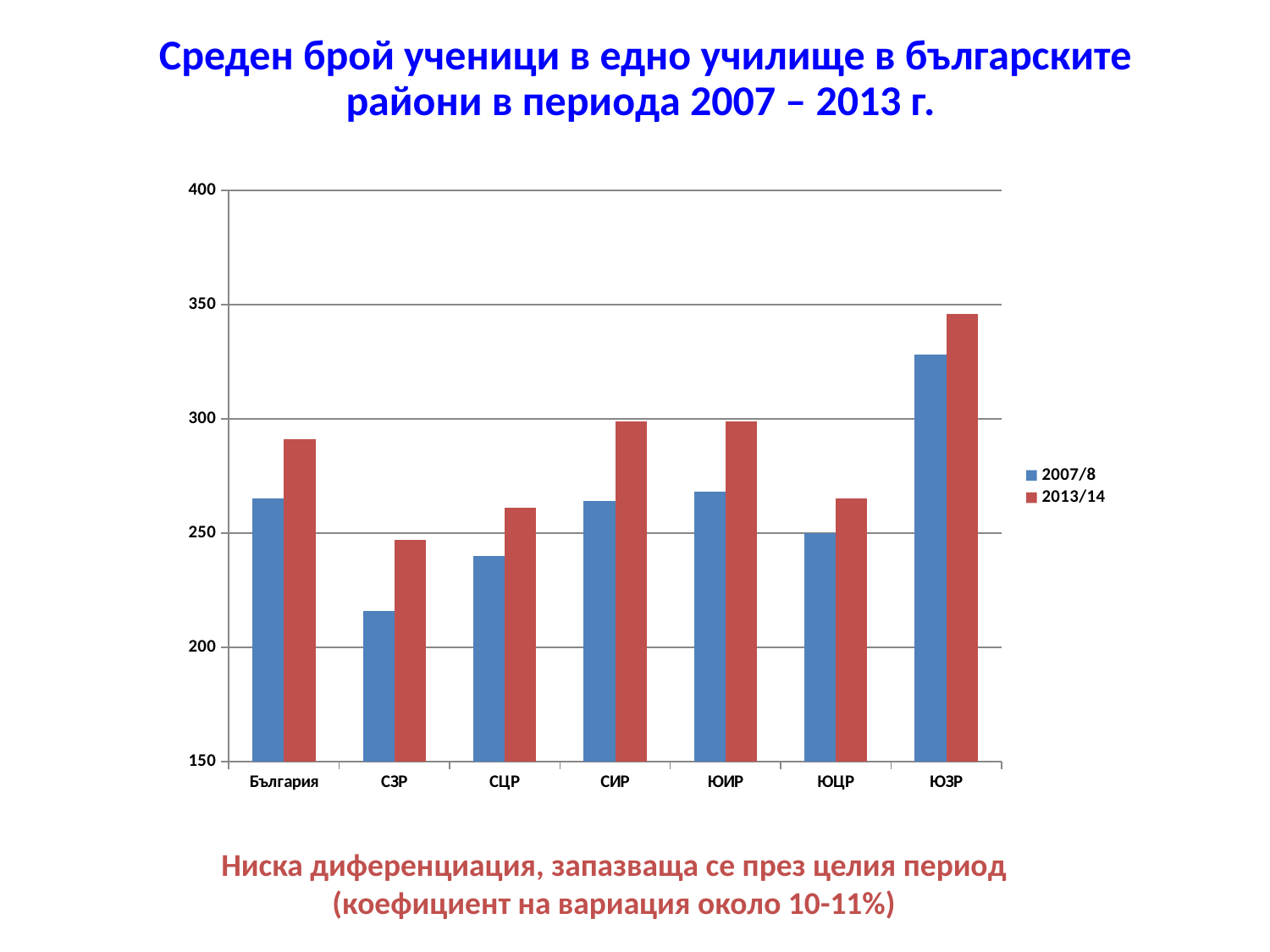
How many series does the chart's legend list? 2 What are the two series listed in the chart's legend? 2007/8 and 2013/14 Which category has the highest value for the 2013/14 series? ЮЗР Which category has the highest value for the 2007/8 series? ЮЗР What kind of chart is shown on the slide? bar chart For СЗР, which series has the larger value, 2007/8 or 2013/14? 2013/14 Is the 2013/14 value for ЮЗР greater or less than 350? less Is the 2007/8 value for ЮЗР greater or less than 300? greater Which category has the lowest value for the 2007/8 series? СЗР Is the 2007/8 value for СЗР greater or less than 250? less How many categories are shown along the x axis of the chart? 7 Which category has the lowest value for the 2013/14 series? СЗР